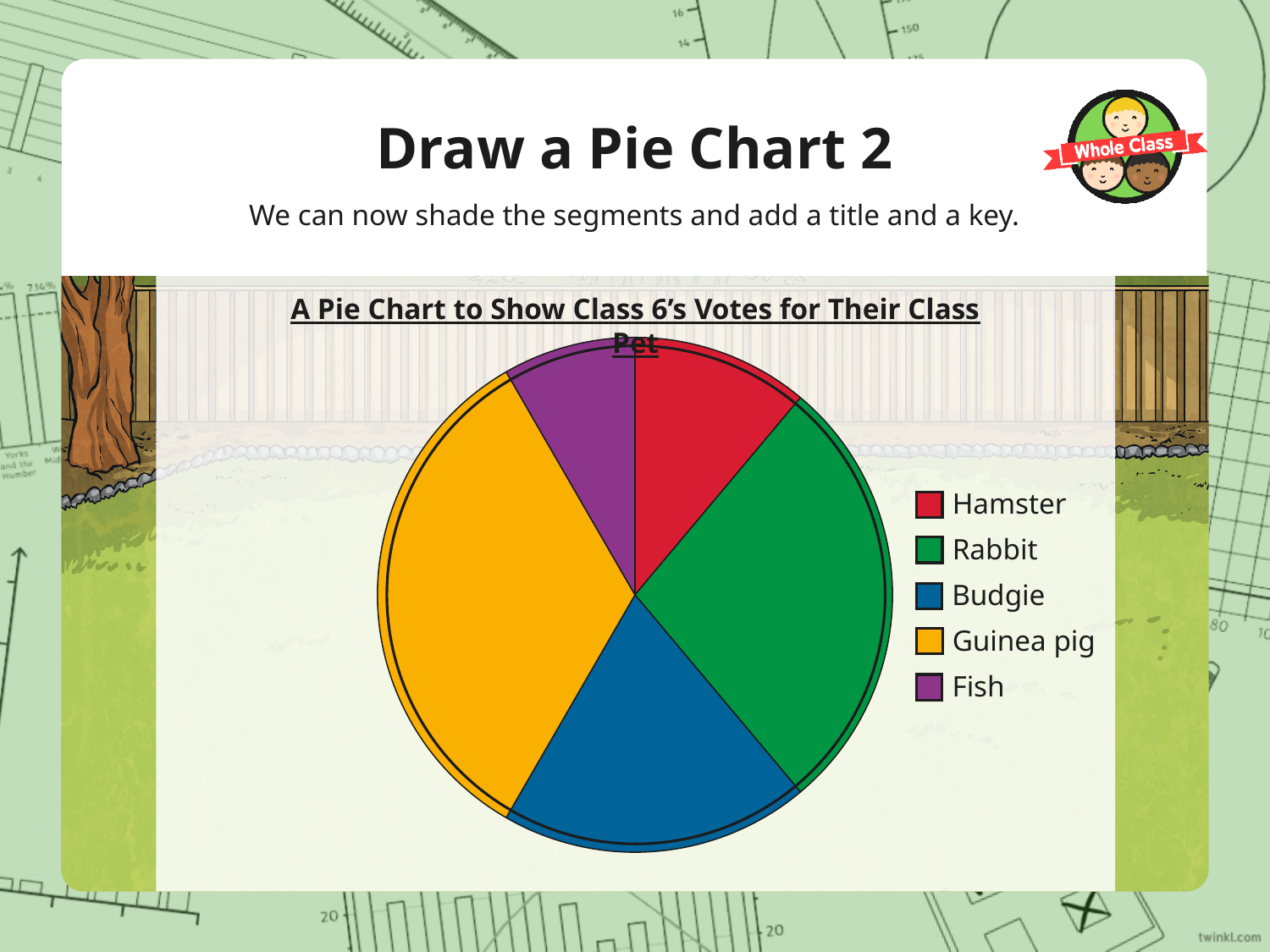
What kind of chart is shown on the slide? Pie chart Which has the larger slice, Hamster or Fish? Hamster Which has the larger slice, Rabbit or Budgie? Rabbit Which pet received the fewest votes according to the pie chart? Fish Which pet received the most votes according to the pie chart? Guinea pig How many entries does the key list? 5 What is the title of the pie chart? A Pie Chart to Show Class 6's Votes for Their Class Pet How many categories (pets) does the pie chart show? 5 Which has the larger slice, Budgie or Hamster? Budgie What colour represents Budgie in the key? Blue